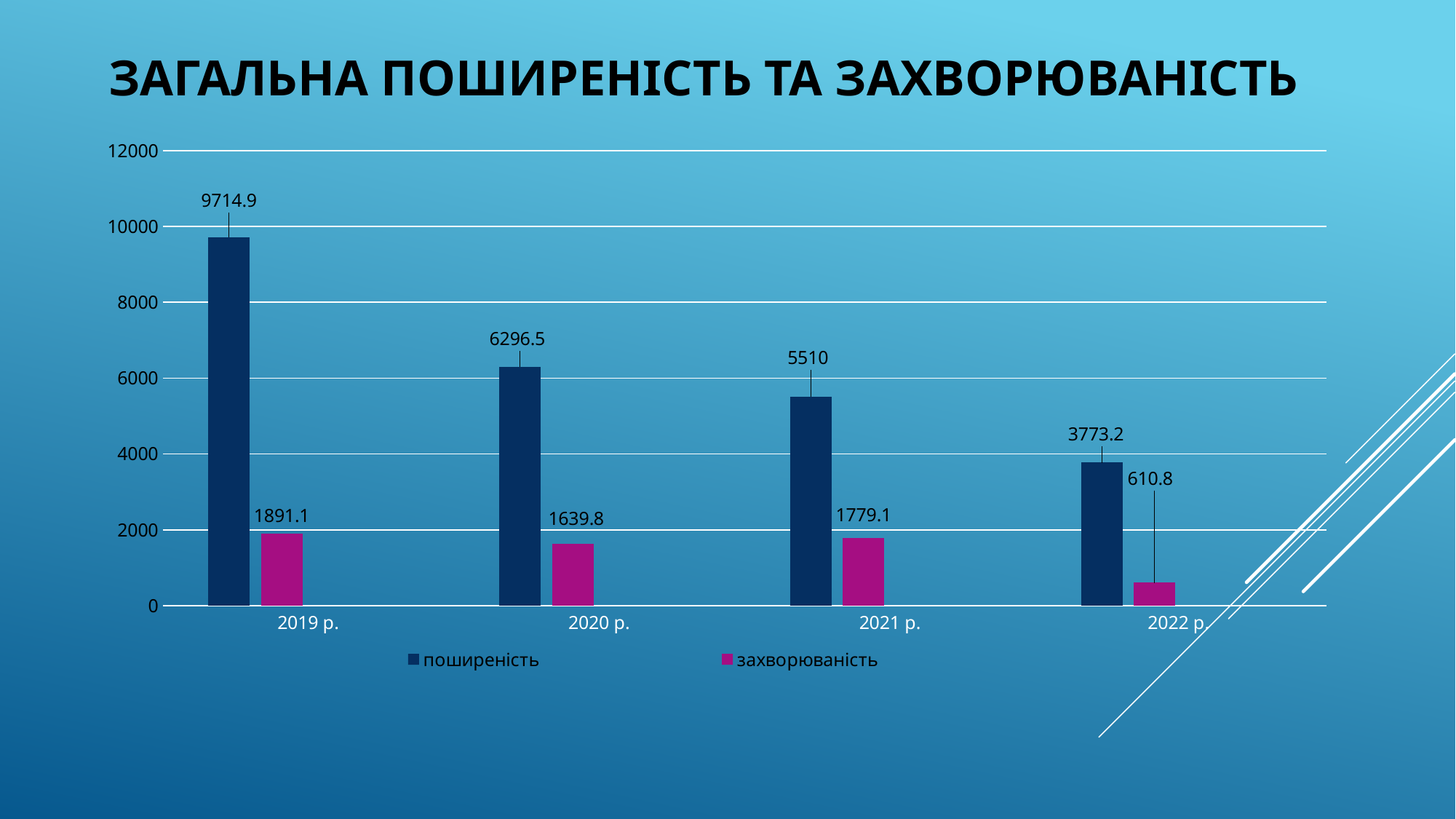
Which is larger: захворюваність in 2020 р. or захворюваність in 2021 р.? 2021 р. What is the value of поширеність for 2019 р.? 9714.9 How many years are shown on the x axis? 4 What is the value of поширеність for 2021 р.? 5510 Which year has the lowest захворюваність value? 2022 р. What is the value of захворюваність for 2022 р.? 610.8 Which year has the highest поширеність value? 2019 р. How many series does the legend list? 2 What is the difference between поширеність and захворюваність in 2019 р.? 7823.8 Is the value of поширеність for 2020 р. greater or less than 6000? greater What kind of chart is shown on the slide? Bar chart What is the difference between the поширеність values for 2020 р. and 2022 р.? 2523.3